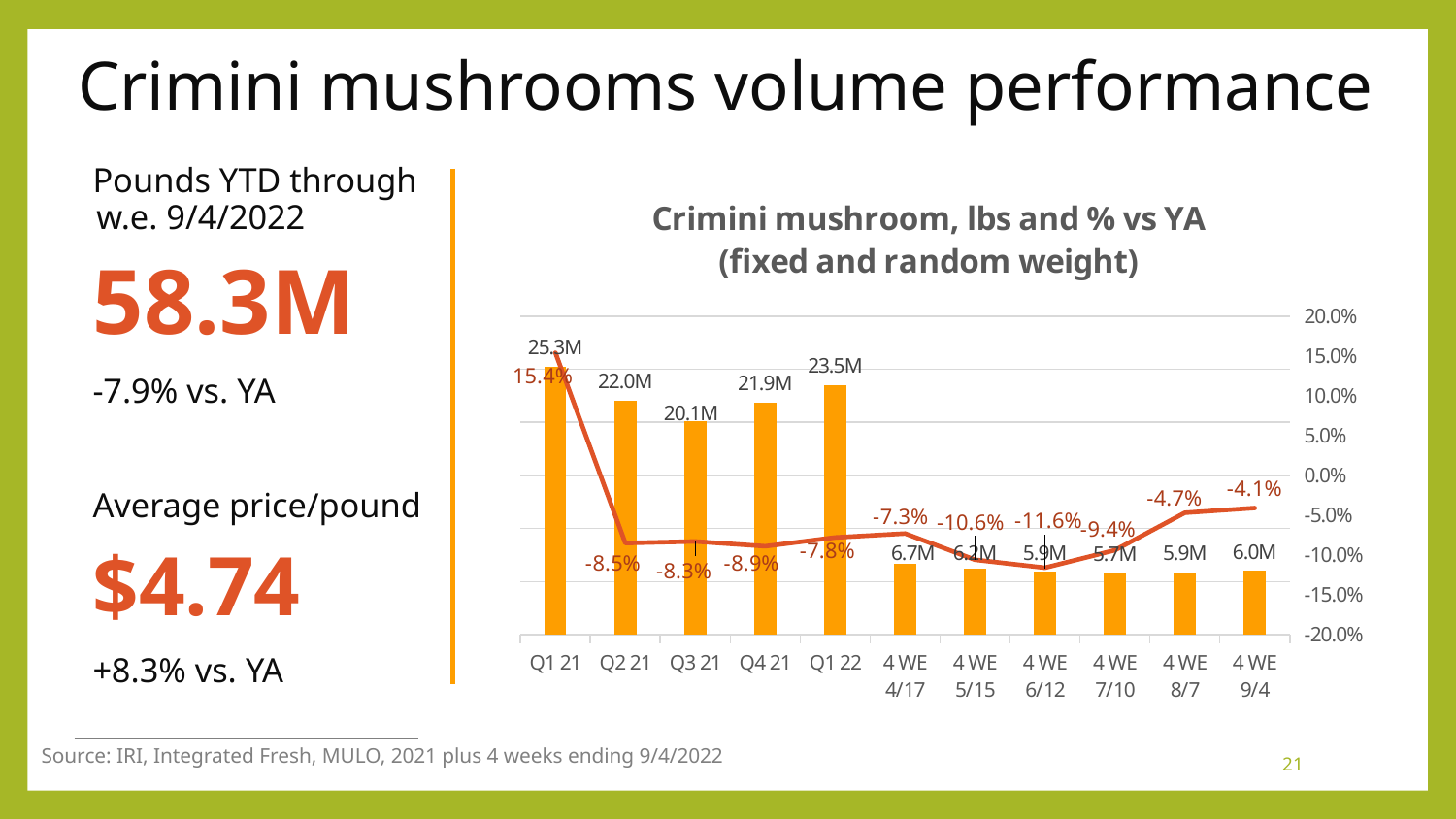
What is the % vs YA value for Q1 22? -7.8% Which period has the highest volume in pounds? Q1 21 What is the volume in pounds for Q1 21? 25.3M How many periods are shown on the x axis? 11 Does the % vs YA line rise or fall from 4 WE 6/12 to 4 WE 9/4? Rise What is the title of the chart? Crimini mushroom, lbs and % vs YA (fixed and random weight) Which is larger, the volume for Q4 21 or Q1 22? Q1 22 What is the % vs YA value for the 4 WE 6/12 period? -11.6% What kind of chart is this? Combined bar and line chart What is the difference in pounds between Q1 21 and Q3 21? 5.1M Which period has the lowest % vs YA value? 4 WE 6/12 What is the volume in pounds for the 4 WE 9/4 period? 6.0M